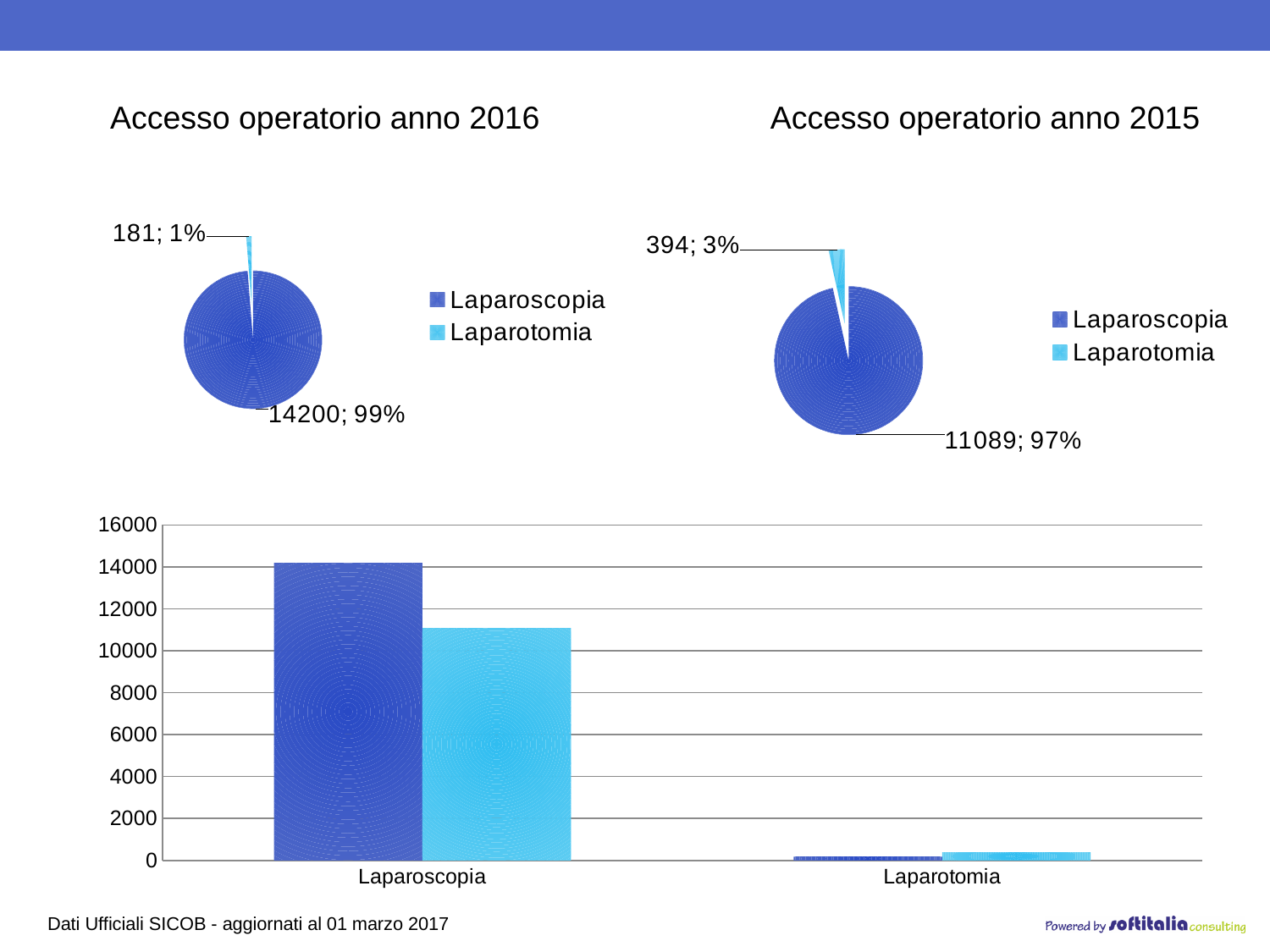
In the chart titled "Accesso operatorio anno 2016", how many entries does the legend list? 2 In the chart titled "Accesso operatorio anno 2016", what is the value for Laparoscopia? 14200 In the chart titled "Accesso operatorio anno 2015", what is the value for Laparoscopia? 11089 What kind of chart is the chart at the bottom of the slide? bar chart In the chart titled "Accesso operatorio anno 2015", what share of the pie does Laparotomia represent? 3% In the chart titled "Accesso operatorio anno 2016", what share of the pie does Laparoscopia represent? 99% In the chart titled "Accesso operatorio anno 2016", what is the difference between the Laparoscopia and Laparotomia values? 14019 In the chart titled "Accesso operatorio anno 2015", what is the value for Laparotomia? 394 In the chart titled "Accesso operatorio anno 2015", which category is the largest? Laparoscopia In the bar chart at the bottom of the slide, how many categories are shown on the x axis? 2 In the chart titled "Accesso operatorio anno 2016", what is the value for Laparotomia? 181 In the bar chart at the bottom of the slide, is the value of the dark blue bar for Laparoscopia greater or less than 12000? greater